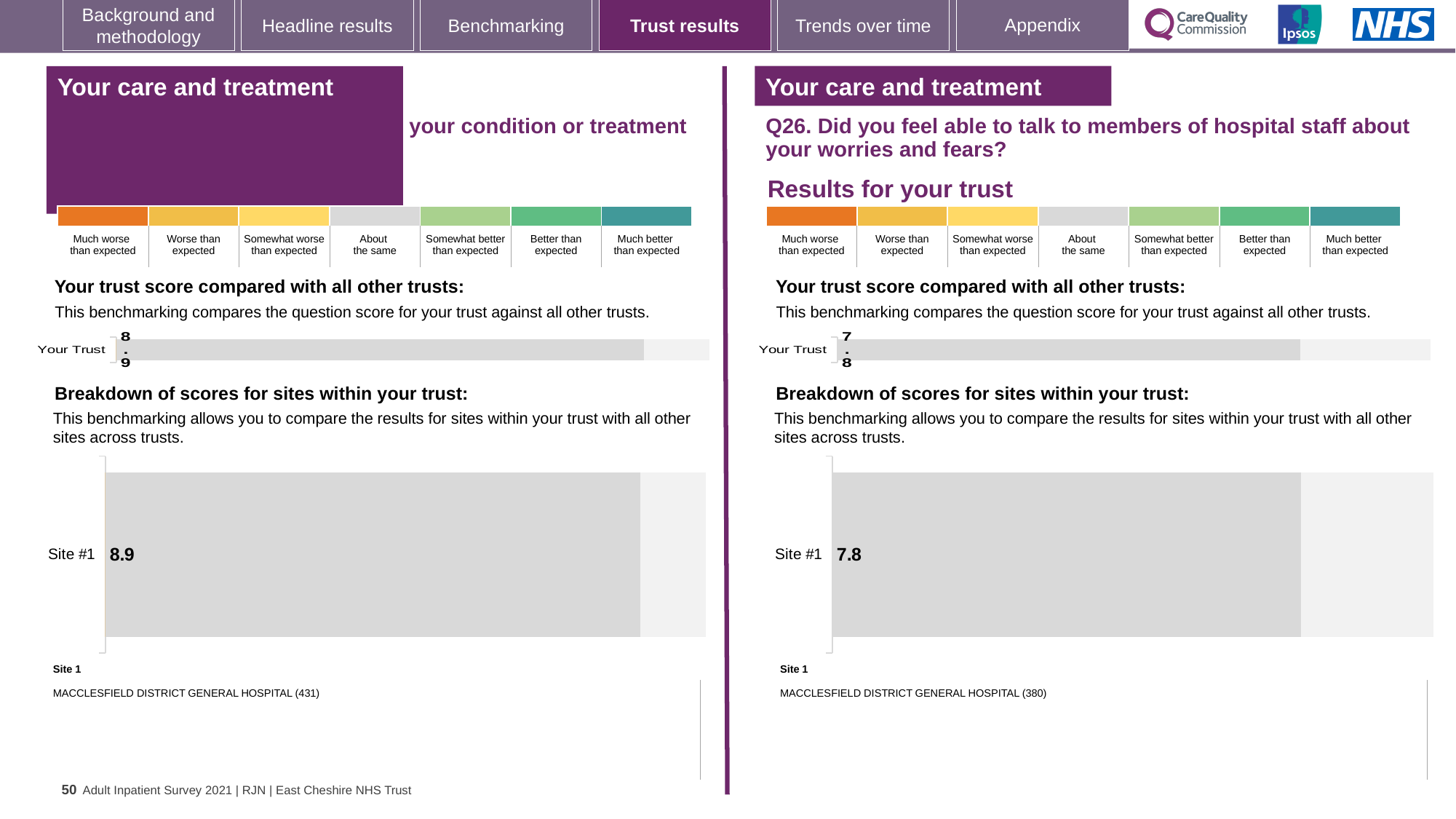
How many sites are shown in the 'Breakdown of scores for sites within your trust' chart on the right-hand panel (Q26)? 1 How many categories does the colour scale above each chart show, from 'Much worse than expected' to 'Much better than expected'? 7 What is the difference between the Site #1 score on the left-hand panel (8.9) and the Site #1 score on the right-hand panel (7.8)? 1.1 On the left-hand panel, what score is shown for Site #1 in the 'Breakdown of scores for sites within your trust' chart? 8.9 On the left-hand panel, what is the score shown for Your Trust in the 'Your trust score compared with all other trusts' chart? 8.9 On the right-hand panel (Q26), what is the score shown for Your Trust in the 'Your trust score compared with all other trusts' chart? 7.8 What is the difference between the Your Trust score on the left-hand panel and the Your Trust score on the right-hand panel (Q26)? 1.1 What type of chart is used to show the Site #1 score on the left-hand panel? Bar chart On the right-hand panel (Q26), what score is shown for Site #1 in the 'Breakdown of scores for sites within your trust' chart? 7.8 Which is larger: the Site #1 score on the left-hand panel or the Site #1 score on the right-hand panel (Q26)? Left-hand panel (8.9) Which hospital is listed as Site 1 on the right-hand panel (Q26)? MACCLESFIELD DISTRICT GENERAL HOSPITAL (380)